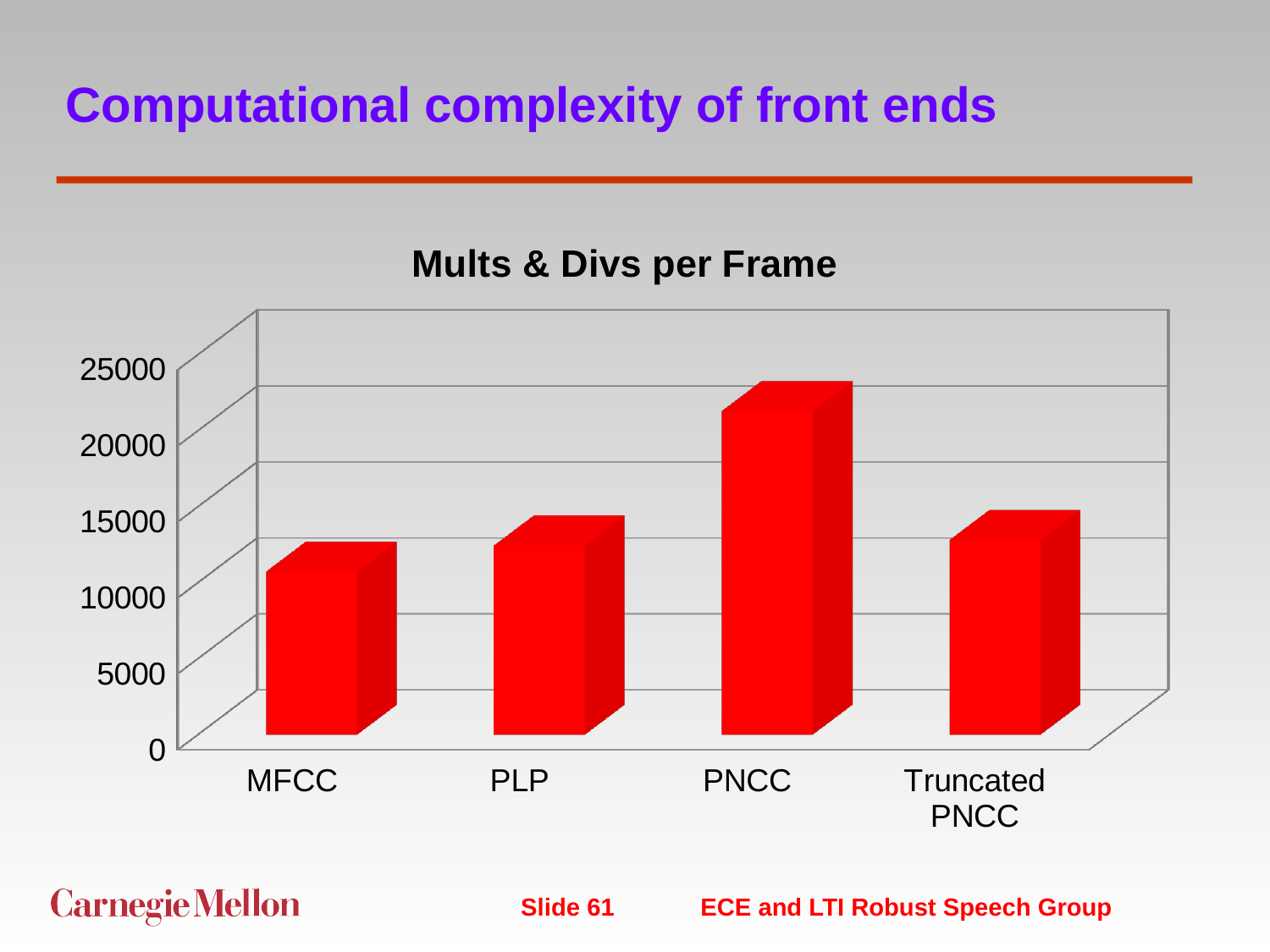
What is the title of the chart? Mults & Divs per Frame Which front end has the highest number of Mults & Divs per Frame? PNCC What kind of chart is shown on the slide? bar chart Is the value for PNCC greater or less than 20000? greater Which front end has the lowest number of Mults & Divs per Frame? MFCC What colour are the bars in the chart? red How many front ends (categories) are shown on the x axis of the chart? 4 Is the value for Truncated PNCC greater or less than 15000? less Is the value for PLP greater or less than 10000? greater Which has more Mults & Divs per Frame, MFCC or PLP? PLP